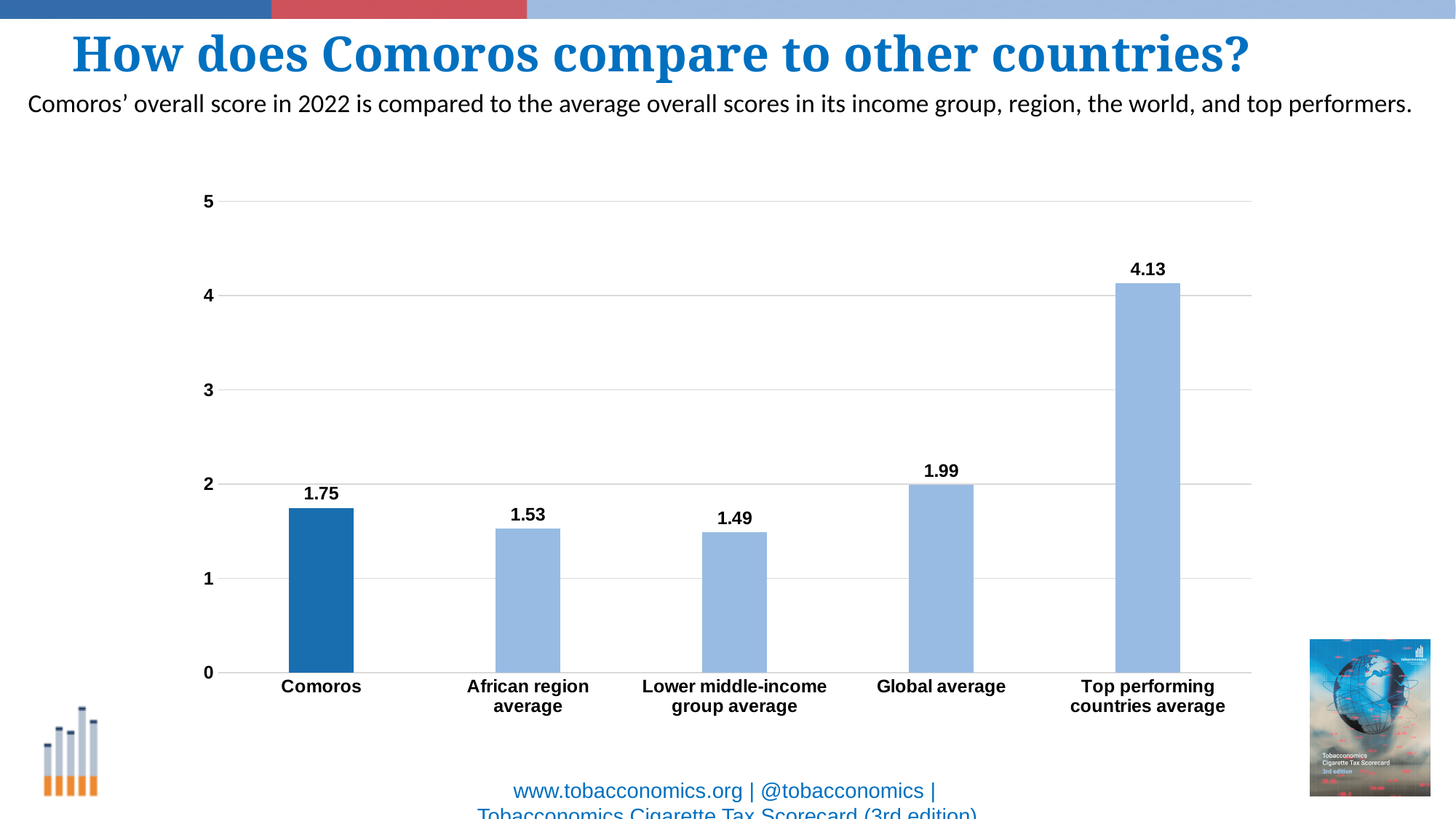
What is the value for the Lower middle-income group average? 1.49 How many categories are shown on the chart? 5 Which is larger, the value for Comoros or the African region average? Comoros Which category has the lowest value? Lower middle-income group average What is the difference between the Top performing countries average and Comoros? 2.38 What kind of chart is shown on the slide? Bar chart Which category has the highest value? Top performing countries average What is the value for the African region average? 1.53 What is the difference between the Global average and Comoros? 0.24 What is the overall score for Comoros? 1.75 What is the value for the Global average? 1.99 What is the value for the Top performing countries average? 4.13